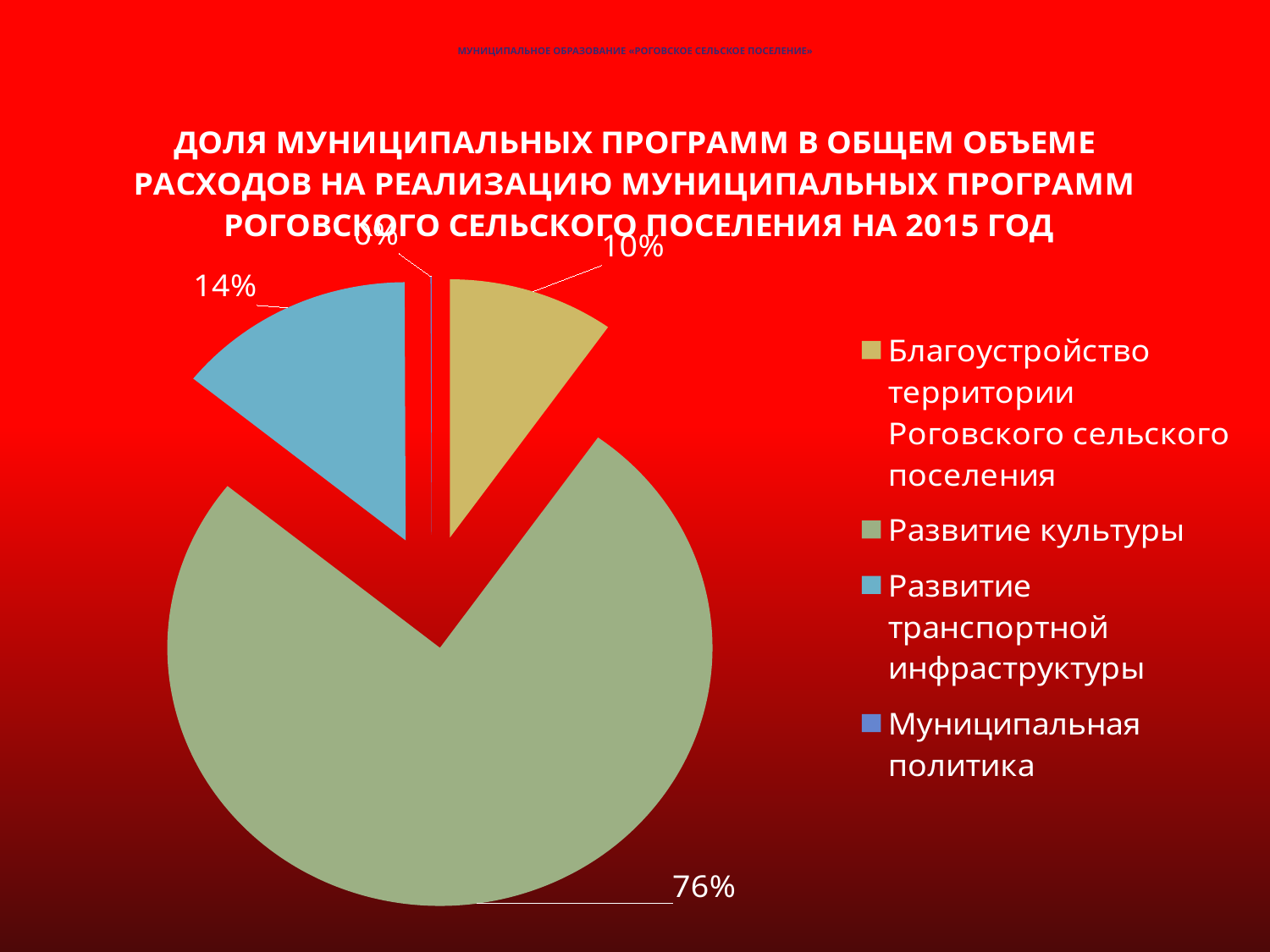
What is the difference in percentage points between the share for "Развитие культуры" and the share for "Развитие транспортной инфраструктуры"? 62 Which year does the chart title say the data refers to? 2015 Which is larger: the share for "Развитие транспортной инфраструктуры" or the share for "Благоустройство территории Роговского сельского поселения"? Развитие транспортной инфраструктуры What is the difference in percentage points between the share for "Развитие транспортной инфраструктуры" and the share for "Благоустройство территории Роговского сельского поселения"? 4 What type of chart is shown on the slide? pie chart What share of the pie does "Развитие транспортной инфраструктуры" have? 14% What share of the pie does "Муниципальная политика" have? 0% What share of the pie does "Благоустройство территории Роговского сельского поселения" have? 10% Which category has the smallest share of the pie? Муниципальная политика Which category has the largest share of the pie? Развитие культуры How many categories does the legend list? 4